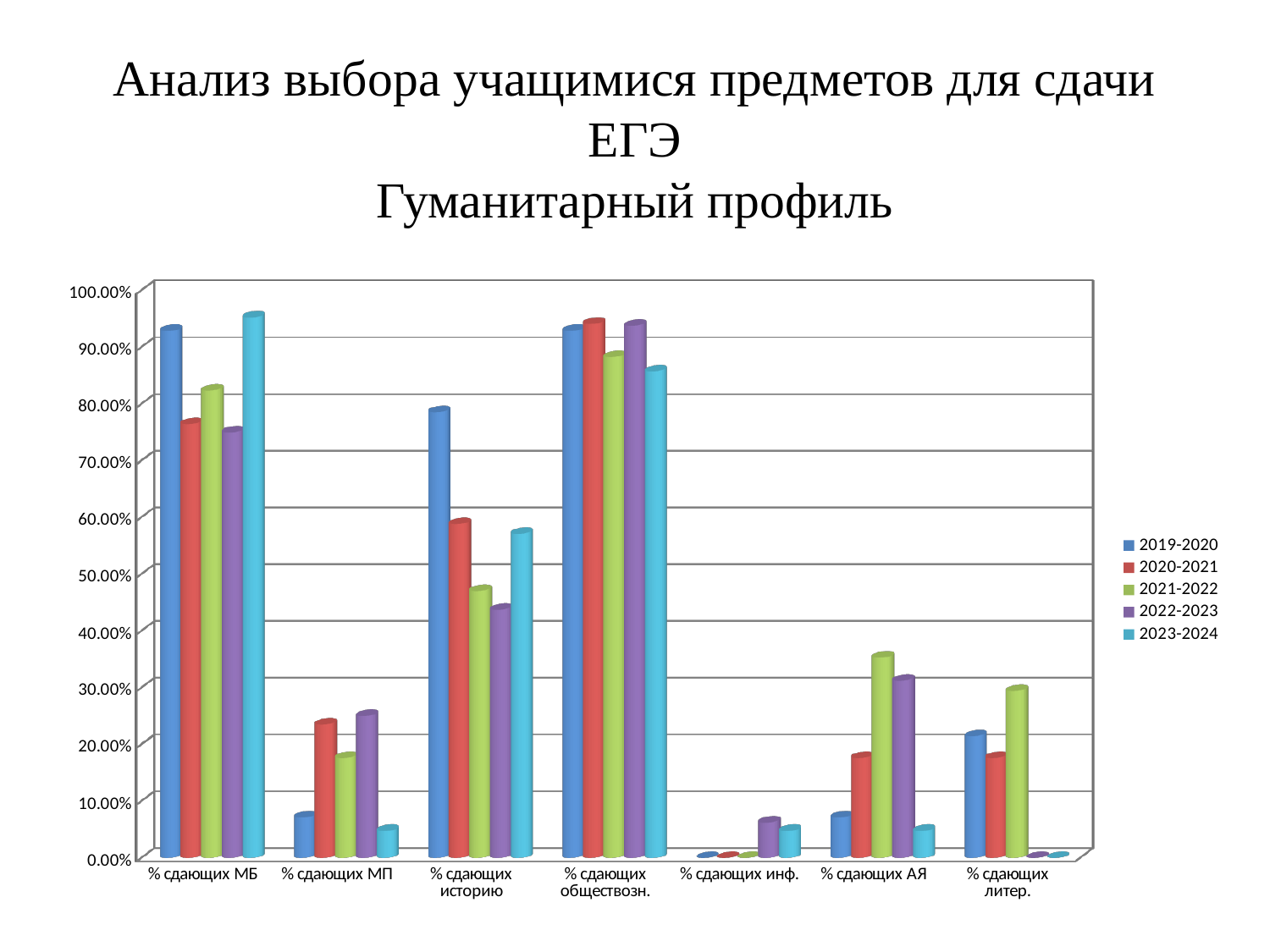
How many series does the legend list? 5 Is the value for % сдающих инф. in 2022-2023 greater or less than 10.00%? less Which series is listed first in the legend? 2019-2020 Which category has the highest value for the 2021-2022 series? % сдающих обществозн. For % сдающих МП, which is larger: the value for 2022-2023 or for 2023-2024? 2022-2023 Is the value for % сдающих АЯ in 2019-2020 greater or less than 10.00%? less What kind of chart is shown on the slide? bar chart How many categories are shown on the x axis? 7 Is the value for % сдающих обществозн. in 2023-2024 greater or less than 80.00%? greater For % сдающих АЯ, which series has the highest value? 2021-2022 For % сдающих историю, which is larger: the value for 2019-2020 or for 2020-2021? 2019-2020